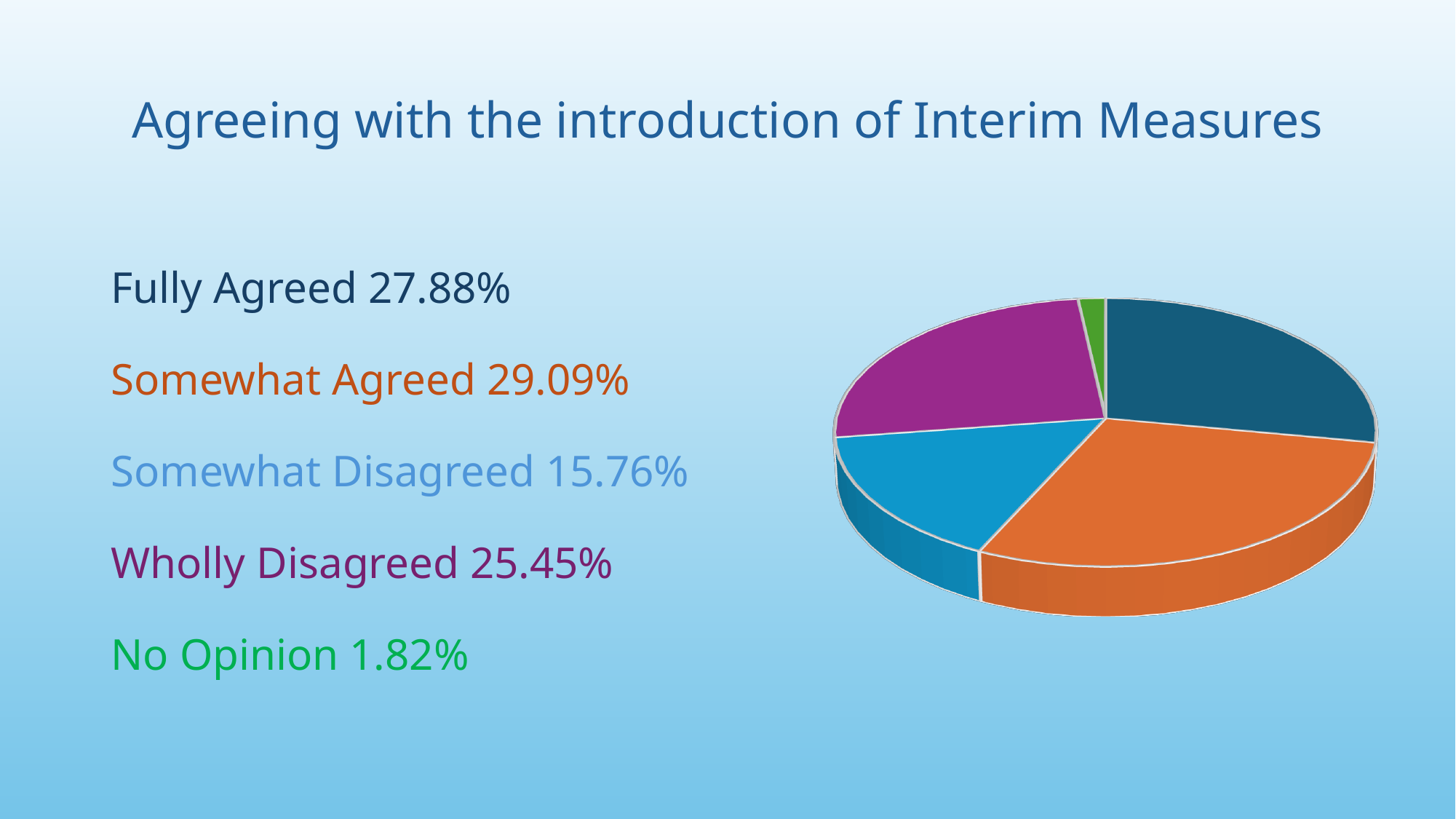
Which is larger, the share for Fully Agreed or the share for Wholly Disagreed? Fully Agreed What type of chart is shown on the slide? Pie chart What percentage of respondents Wholly Disagreed? 25.45% What percentage of respondents Fully Agreed with the introduction of Interim Measures? 27.88% What is the title of the slide containing the chart? Agreeing with the introduction of Interim Measures What is the difference in percentage points between Wholly Disagreed and Somewhat Disagreed? 9.69 Which response category has the largest share of the pie? Somewhat Agreed What share of respondents Somewhat Disagreed? 15.76% How many response categories are shown in the pie chart? 5 What is the difference in percentage points between Somewhat Agreed and Fully Agreed? 1.21 What percentage is shown for No Opinion? 1.82% Which response category has the smallest share of the pie? No Opinion